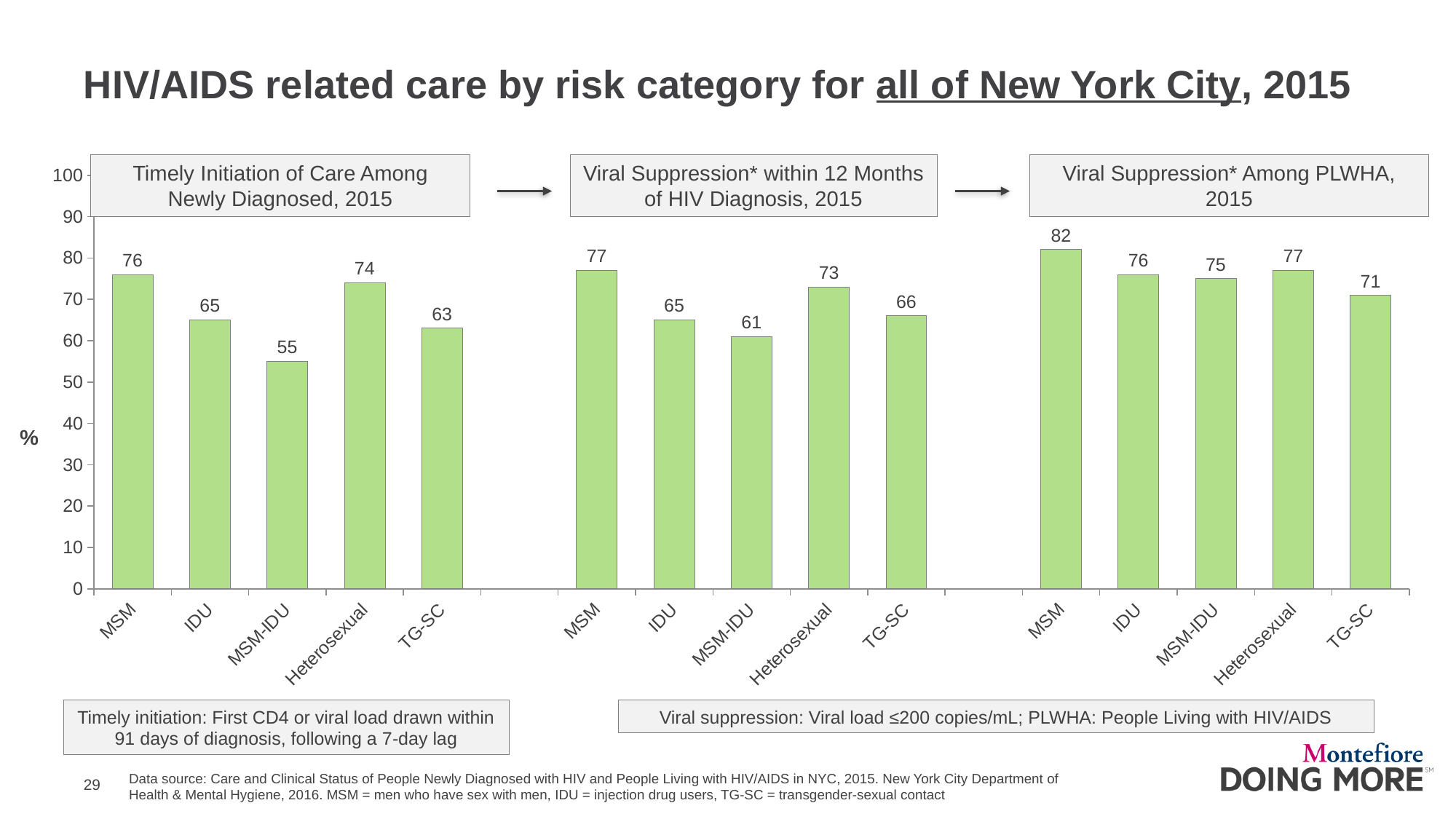
What label is shown on the vertical axis of the chart? % In the "Viral Suppression* Among PLWHA, 2015" group, what is the value for Heterosexual? 77 Which risk category has the lowest value in the "Timely Initiation of Care Among Newly Diagnosed, 2015" group? MSM-IDU Which risk category has the highest value in the "Viral Suppression* Among PLWHA, 2015" group? MSM How many risk categories are shown in each of the three groups on the chart? 5 In the "Viral Suppression* within 12 Months of HIV Diagnosis, 2015" group, what is the value for TG-SC? 66 In the "Timely Initiation of Care Among Newly Diagnosed, 2015" group, what is the value for MSM-IDU? 55 What is the difference between the MSM value in the "Viral Suppression* Among PLWHA, 2015" group and the MSM value in the "Timely Initiation of Care Among Newly Diagnosed, 2015" group? 6 In the "Timely Initiation of Care Among Newly Diagnosed, 2015" group, which is larger: the value for IDU or the value for TG-SC? IDU What kind of chart is shown on the slide? Bar chart Is the value for MSM in the "Viral Suppression* Among PLWHA, 2015" group greater or less than 80? greater What is the difference between the MSM and MSM-IDU values in the "Viral Suppression* within 12 Months of HIV Diagnosis, 2015" group? 16